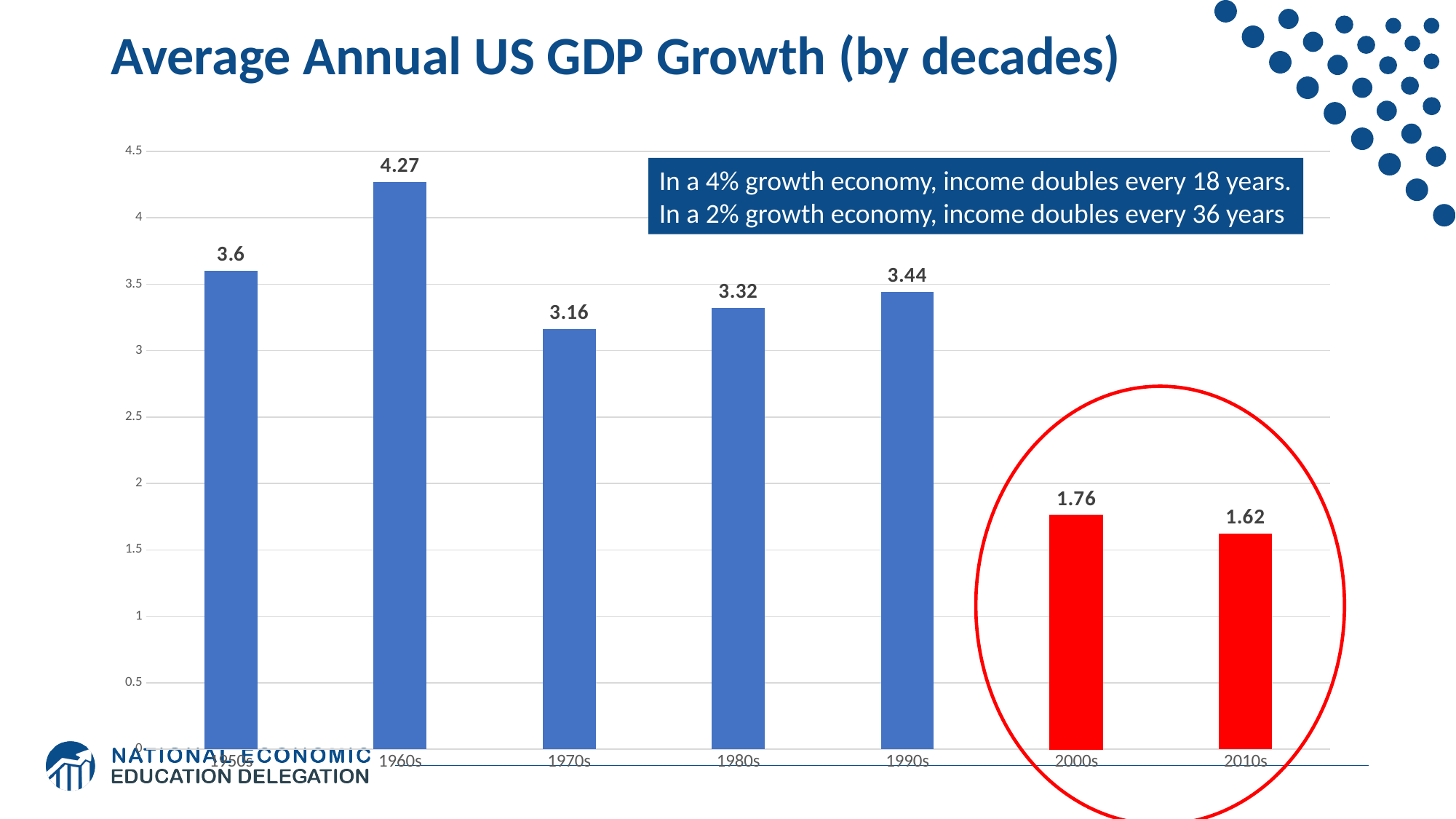
What is the difference between the 1990s value and the 1980s value? 0.12 What is the average annual US GDP growth shown for the 2010s? 1.62 How many decades are shown on the chart? 7 What kind of chart is shown on the slide? bar chart Which decade has the lowest average annual GDP growth? 2010s Is the value for the 2000s greater or less than 2? less What is the difference between the 1960s value and the 2000s value? 2.51 Which bars are coloured red on the chart? 2000s and 2010s Which is larger, the value for the 1950s or the value for the 1970s? 1950s What is the average annual US GDP growth shown for the 1960s? 4.27 What is the value shown for the 1980s? 3.32 Which decade has the highest average annual GDP growth? 1960s